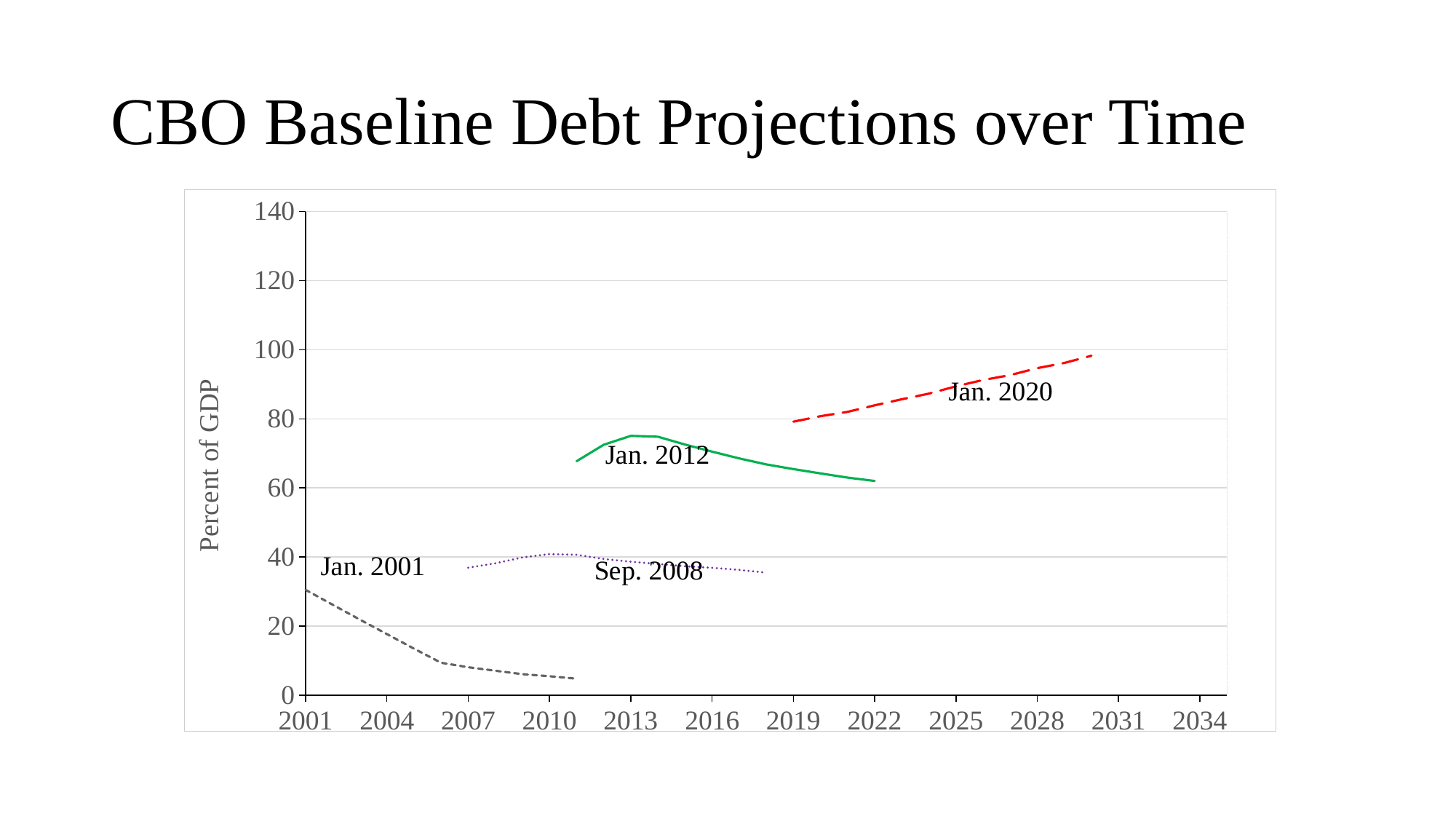
What kind of chart is shown on the slide? line chart Does the Jan. 2001 projection line rise or fall over time? fall Is the value of the Jan. 2020 projection at 2030 greater or less than 80? greater Is the peak value of the Jan. 2012 projection greater or less than 80? less Is the value of the Jan. 2001 projection at 2011 greater or less than 20? less Which projection line reaches the highest value on the chart? Jan. 2020 What is the label on the vertical axis of the chart? Percent of GDP How many projection lines are plotted on the chart? 4 Which projection line is higher, Jan. 2012 or Sep. 2008? Jan. 2012 Which projection line reaches the lowest value on the chart? Jan. 2001 Does the Jan. 2020 projection line rise or fall over time? rise What is the title of the chart? CBO Baseline Debt Projections over Time